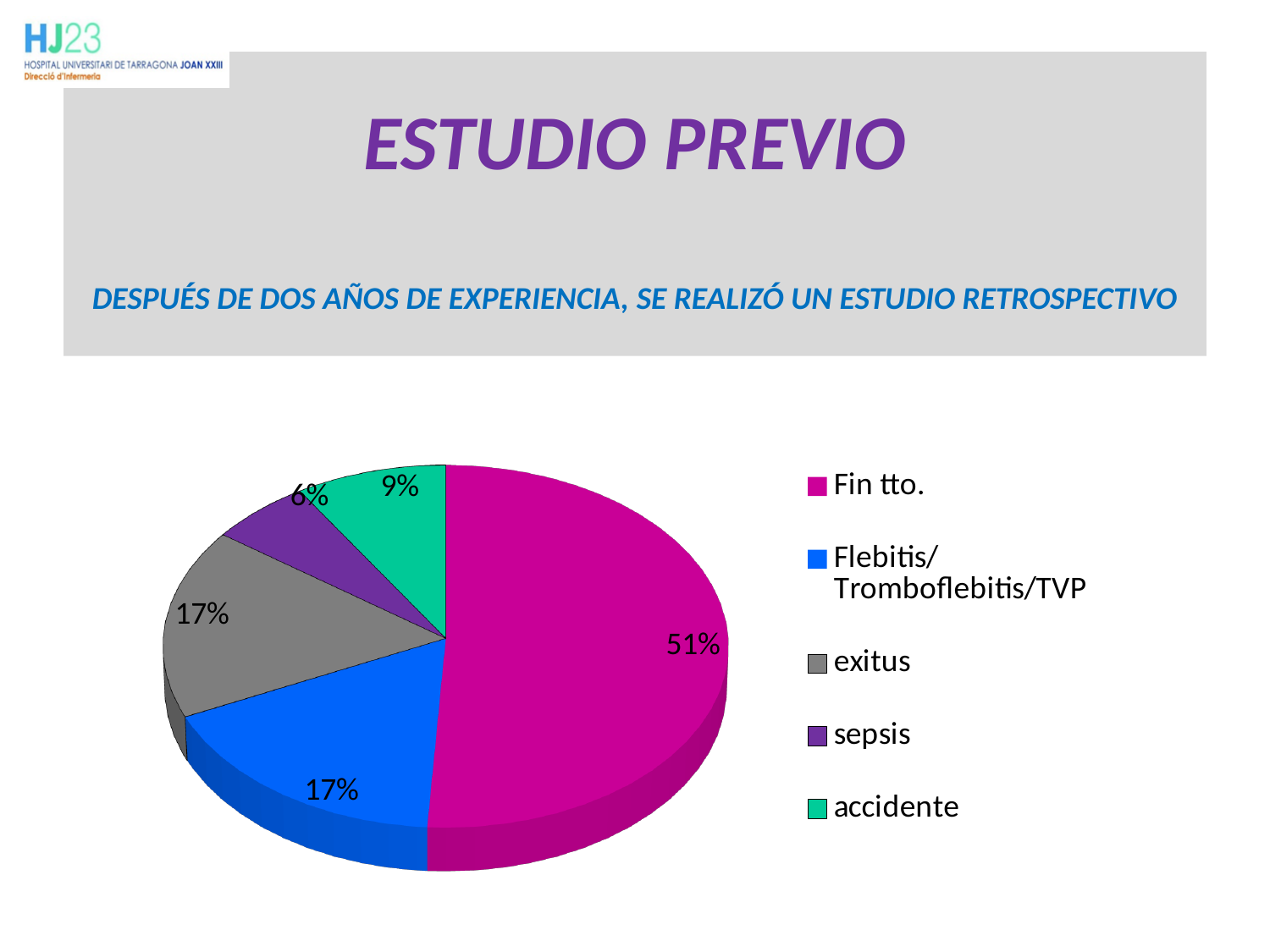
How many categories does the legend list? 5 What share of the pie does "exitus" represent? 17% What share of the pie does "accidente" represent? 9% What colour is the "exitus" slice? grey What is the difference in percentage points between the "Fin tto." slice and the "accidente" slice? 42 Which is larger, the "accidente" slice or the "sepsis" slice? accidente What share of the pie does "sepsis" represent? 6% What kind of chart is shown on the slide? pie chart Which category has the largest slice of the pie? Fin tto. Which category has the smallest slice of the pie? sepsis